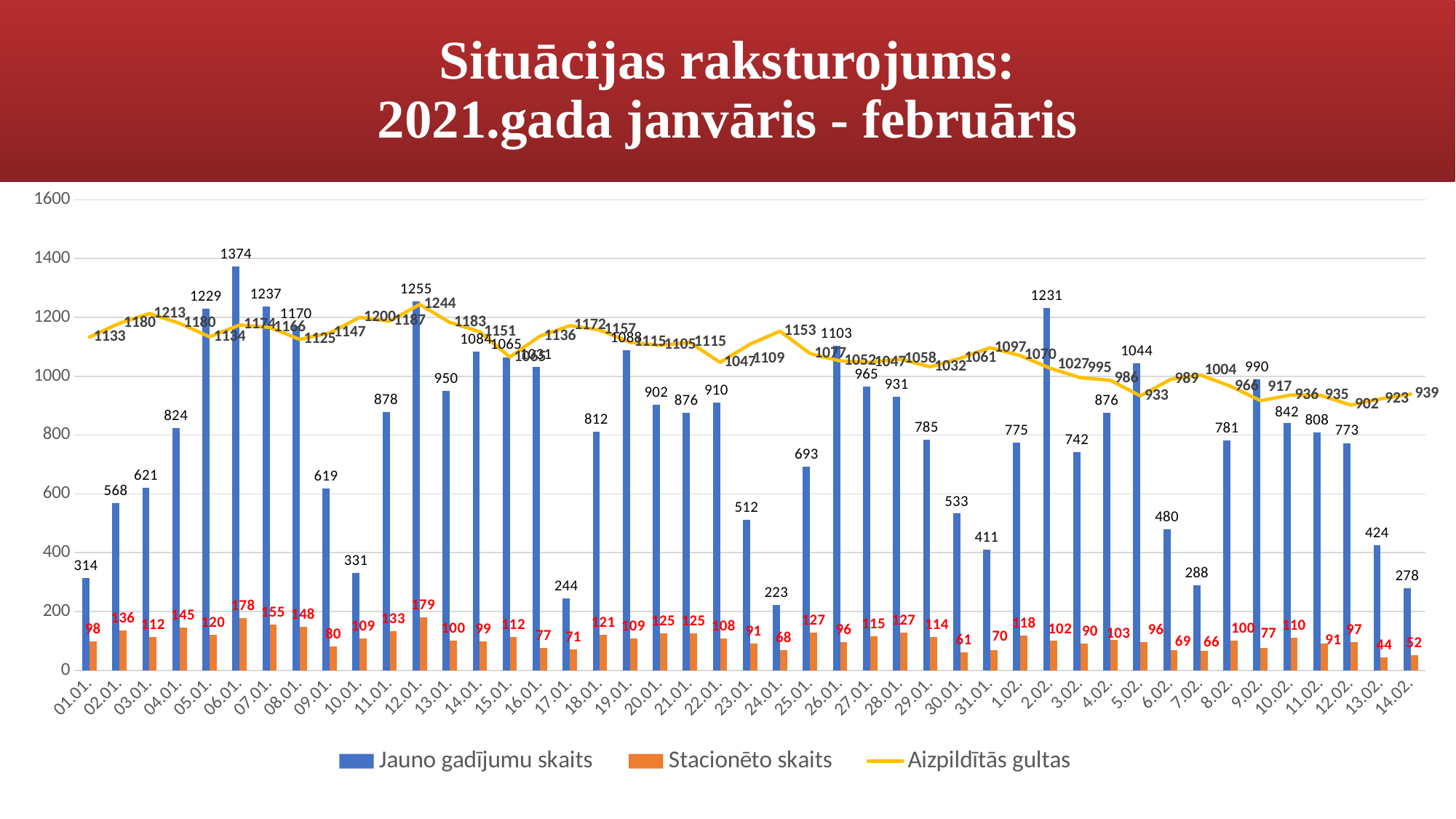
What is the highest value of Stacionēto skaits shown, and on which date? 179 on 12.01. Which is larger, Jauno gadījumu skaits on 12.01. or on 2.02.? 12.01. What is the value of Aizpildītās gultas on 14.02.? 939 On which date is the value for Jauno gadījumu skaits highest? 06.01. What is the highest value of Jauno gadījumu skaits shown? 1374 What is the value of Jauno gadījumu skaits on 01.01.? 314 What is the value of Stacionēto skaits on 14.02.? 52 How many series does the legend list? 3 How many dates are shown on the x axis? 45 On which date is the value for Jauno gadījumu skaits lowest? 24.01. What is the lowest value of Stacionēto skaits shown? 44 What is the difference between Jauno gadījumu skaits on 06.01. and on 05.01.? 145